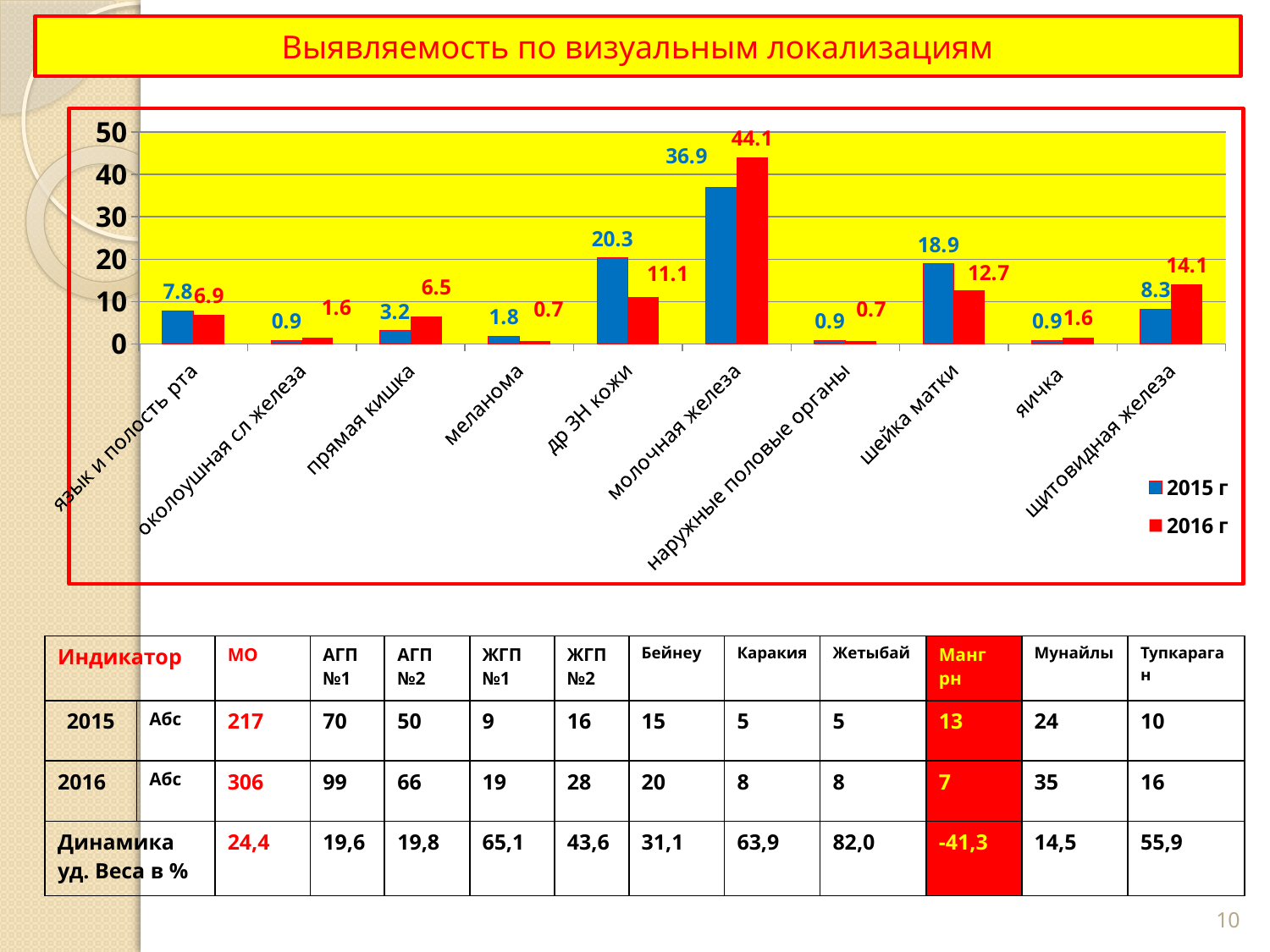
What is the difference between the 2016 г and 2015 г values for молочная железа? 7.2 What type of chart is shown on the slide? bar chart Which category has the highest 2015 г value? молочная железа What is the 2015 г value for др ЗН кожи? 20.3 Is the 2015 г value for др ЗН кожи greater or less than 10? greater What is the 2016 г value for молочная железа? 44.1 How many series does the chart legend list? 2 Which is larger for шейка матки: the 2015 г value or the 2016 г value? 2015 г What is the 2016 г value for щитовидная железа? 14.1 What is the title of the slide containing the chart? Выявляемость по визуальным локализациям How many categories are shown on the x axis of the chart? 10